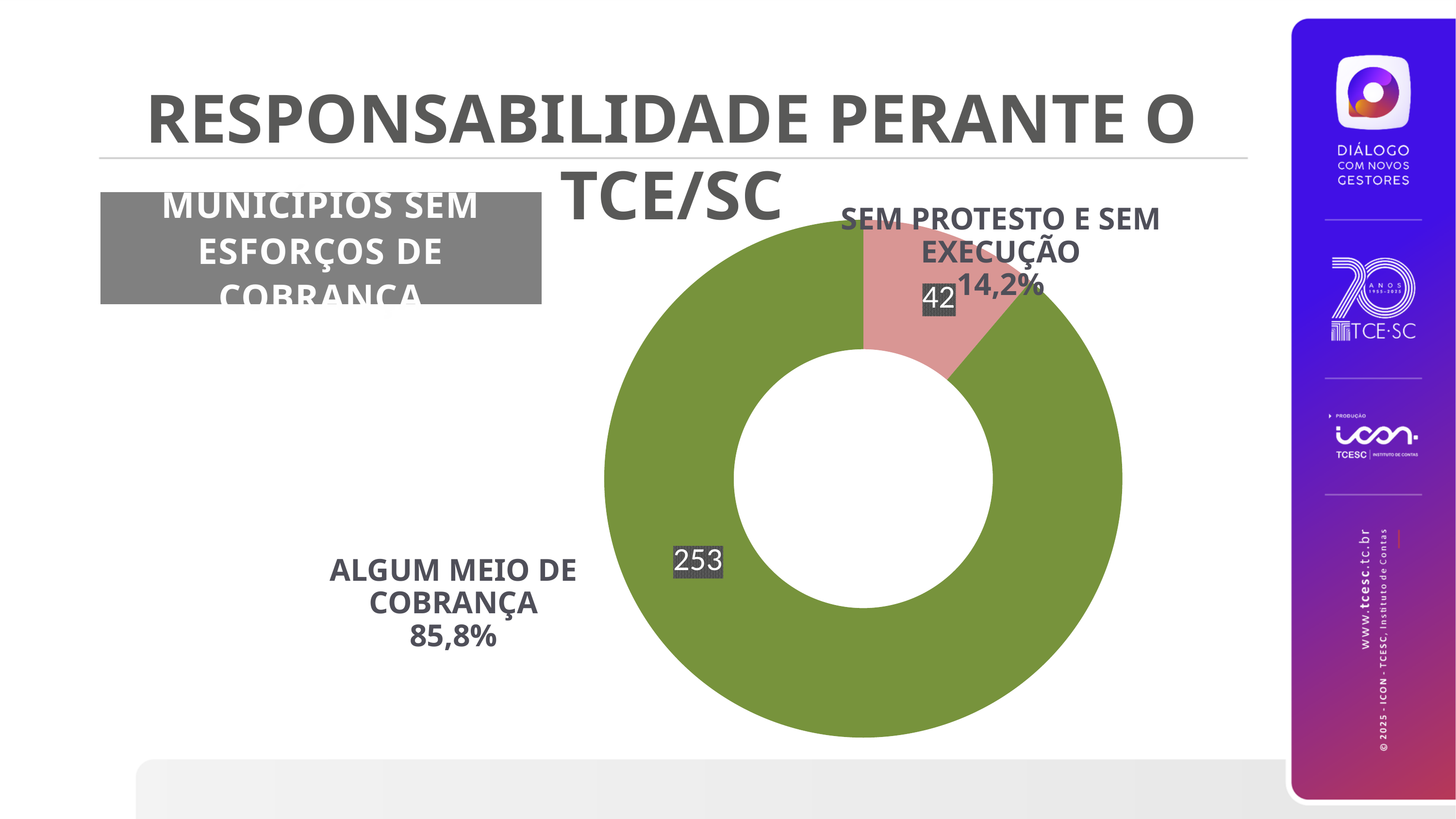
What is the total of the two values shown in the chart? 295 Which category has the largest slice? ALGUM MEIO DE COBRANÇA Which category has the smallest slice? SEM PROTESTO E SEM EXECUÇÃO What percentage share is shown for ALGUM MEIO DE COBRANÇA? 85,8% How many categories does the chart show? 2 Which is larger, the value for ALGUM MEIO DE COBRANÇA or for SEM PROTESTO E SEM EXECUÇÃO? ALGUM MEIO DE COBRANÇA What is the difference between the values for ALGUM MEIO DE COBRANÇA and SEM PROTESTO E SEM EXECUÇÃO? 211 What kind of chart is shown on the slide? Doughnut (pie) chart What is the value for SEM PROTESTO E SEM EXECUÇÃO? 42 What percentage share is shown for SEM PROTESTO E SEM EXECUÇÃO? 14,2% What is the value for ALGUM MEIO DE COBRANÇA? 253 What colour is the slice for SEM PROTESTO E SEM EXECUÇÃO? Pink